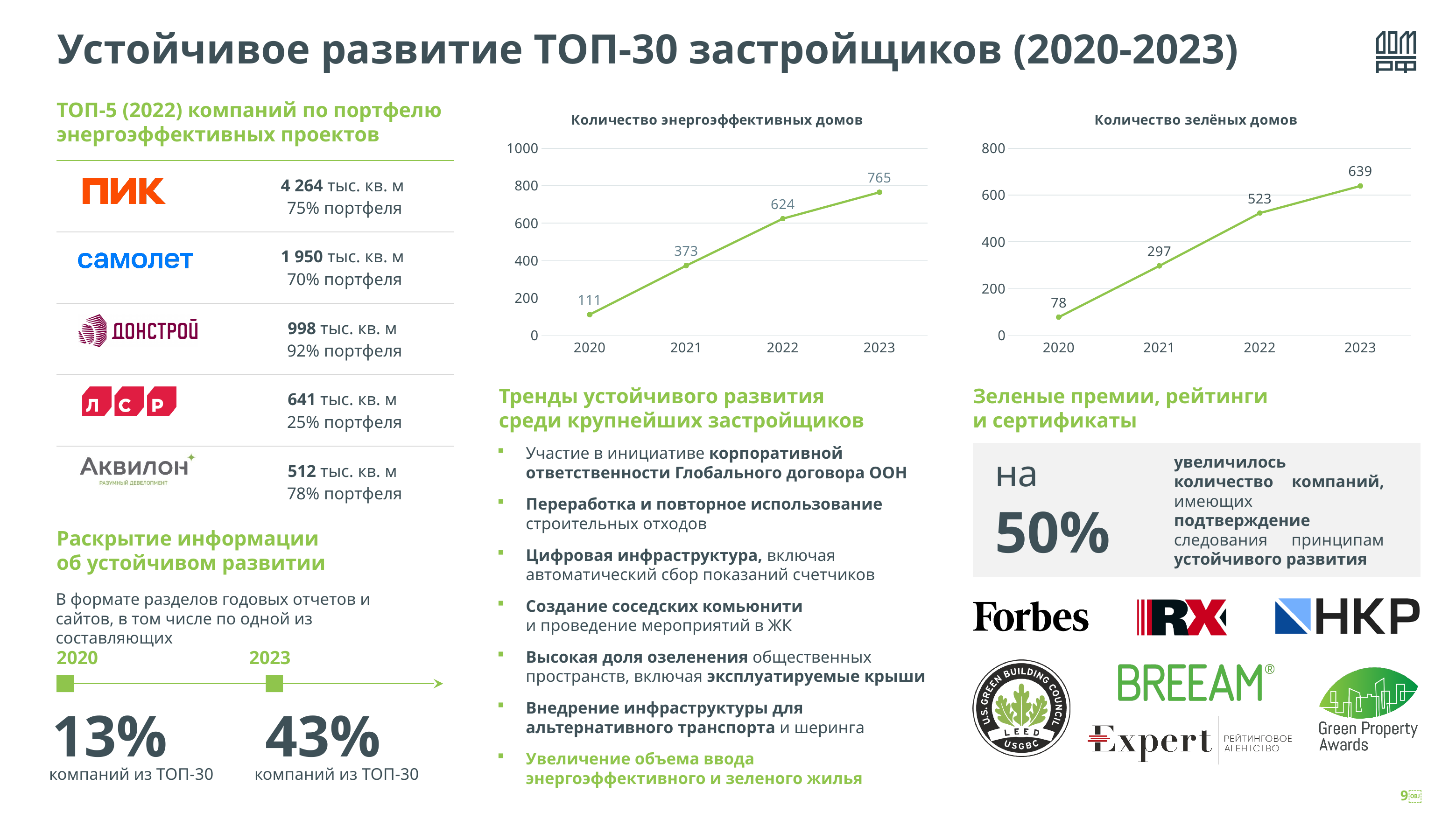
How many data points are plotted in the chart 'Количество энергоэффективных домов'? 4 In the chart 'Количество зелёных домов', what is the value for 2022? 523 What is the title of the chart on the right side of the slide? Количество зелёных домов Which is larger: the 2022 value in 'Количество энергоэффективных домов' or the 2022 value in 'Количество зелёных домов'? Количество энергоэффективных домов (624) What type of chart is 'Количество зелёных домов'? line chart In the chart 'Количество зелёных домов', what is the difference between the values for 2022 and 2021? 226 In the chart 'Количество зелёных домов', which year has the lowest value? 2020 In the chart 'Количество энергоэффективных домов', do the values rise or fall from 2020 to 2023? rise In the chart 'Количество энергоэффективных домов', what is the value for 2021? 373 In the chart 'Количество энергоэффективных домов', what is the difference between the values for 2023 and 2020? 654 In the chart 'Количество зелёных домов', is the value for 2023 greater or less than 600? greater In the chart 'Количество энергоэффективных домов', which year has the highest value? 2023